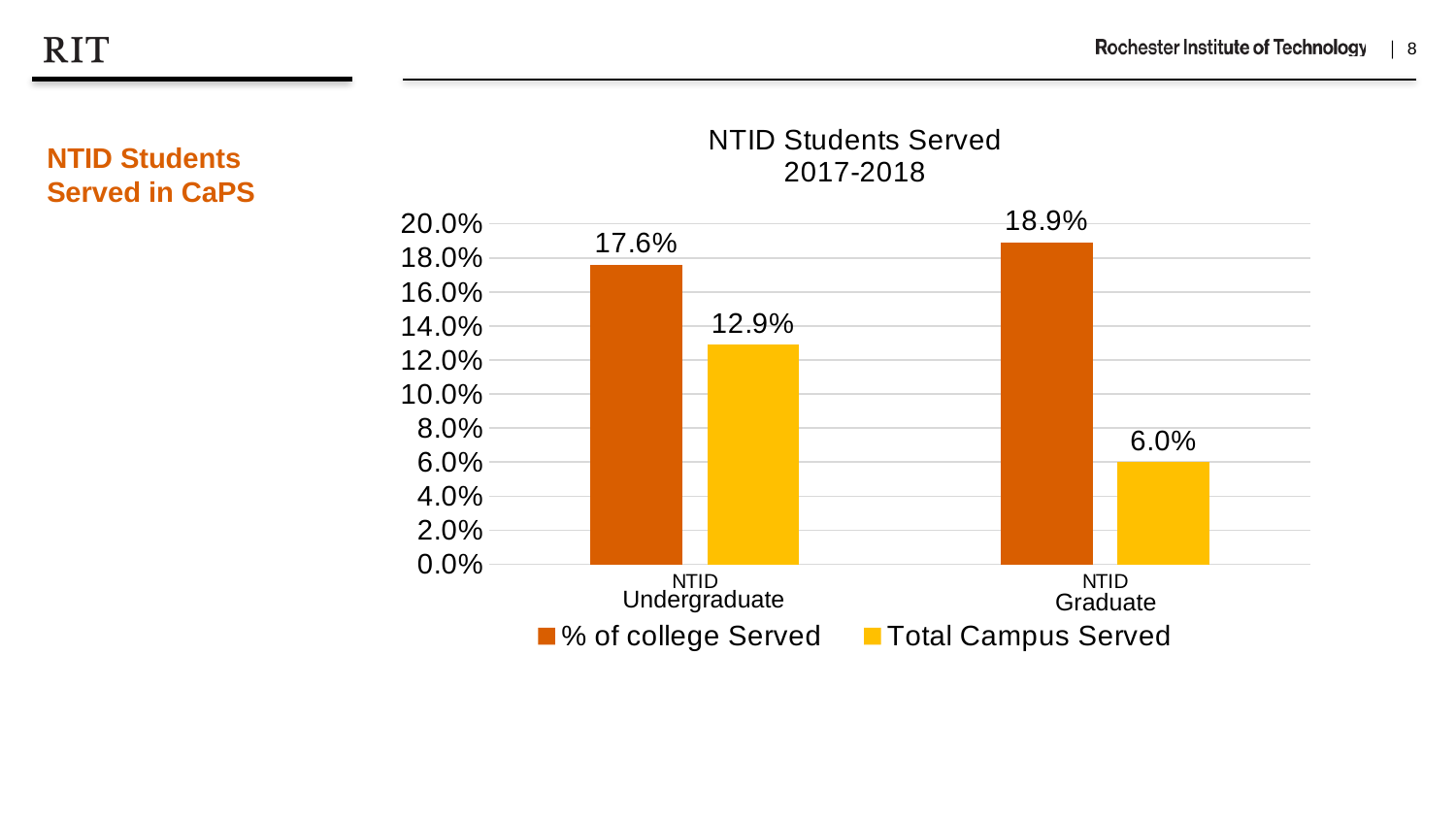
Is "Total Campus Served" for NTID Undergraduate larger or smaller than "Total Campus Served" for NTID Graduate? larger Which category has the lower "Total Campus Served" value? NTID Graduate What is the difference between "% of college Served" and "Total Campus Served" for NTID Undergraduate? 4.7% What is the value of "% of college Served" for NTID Undergraduate? 17.6% What is the difference between "% of college Served" and "Total Campus Served" for NTID Graduate? 12.9% What is the value of "% of college Served" for NTID Graduate? 18.9% What type of chart is shown on the slide? bar chart How many categories are shown on the x axis? 2 What is the value of "Total Campus Served" for NTID Undergraduate? 12.9% How many series does the legend list? 2 Which category has the higher "% of college Served" value? NTID Graduate What is the value of "Total Campus Served" for NTID Graduate? 6.0%